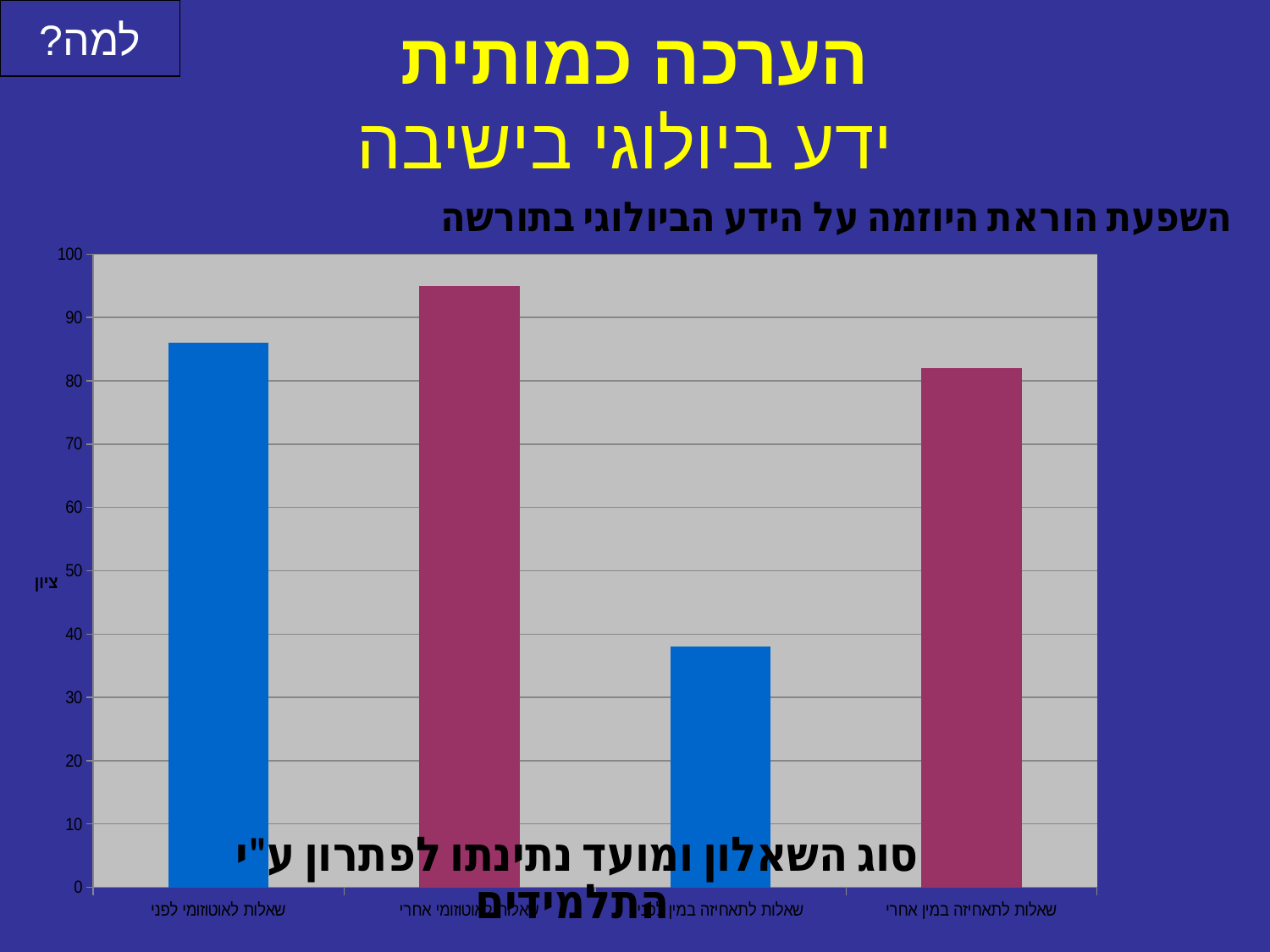
What is the title of the chart? השפעת הוראת היוזמה על הידע הביולוגי בתורשה Is the value for שאלות לתאחיזה במין לפני greater or less than 30? greater Which is larger: the value for שאלות לאוטוזומי אחרי or the value for שאלות לאוטוזומי לפני? שאלות לאוטוזומי אחרי How many bars (categories) are plotted in the chart? 4 Is the value for שאלות לתאחיזה במין לפני greater or less than 40? less Is the value for שאלות לאוטוזומי אחרי greater or less than 90? greater What is the label of the vertical axis of the chart? ציון Which category has the lowest bar in the chart? שאלות לתאחיזה במין לפני What kind of chart is shown on the slide? bar chart Which category has the highest bar in the chart? שאלות לאוטוזומי אחרי